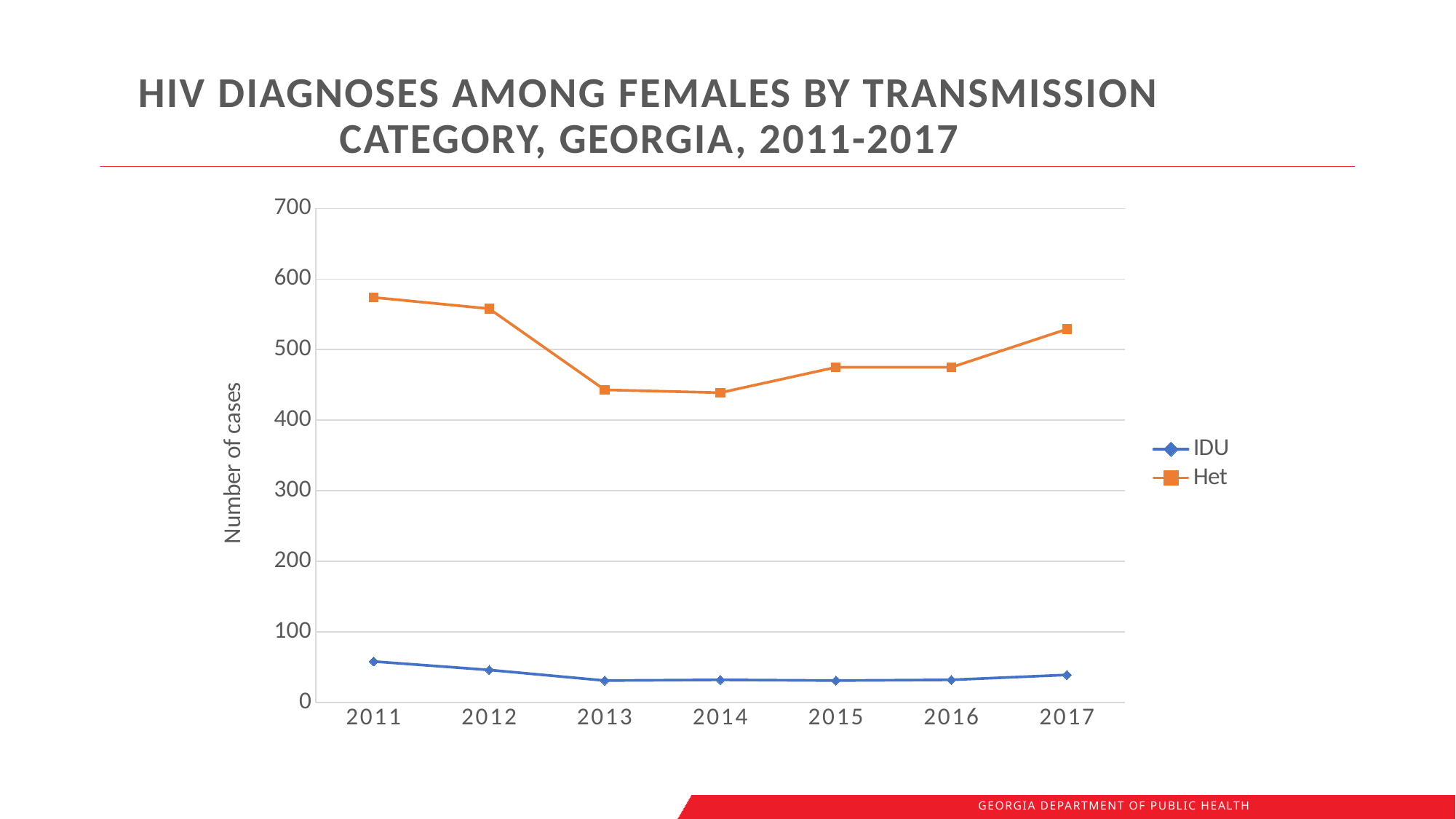
Which is larger, the IDU value in 2011 or the IDU value in 2013? 2011 Is the value for Het in 2013 greater or less than 500? less How many years are plotted along the x axis? 7 Is the value for IDU in 2011 greater or less than 100? less Does the Het series rise or fall from 2014 to 2017? rise In which year is the IDU series at its highest? 2011 In which year is the Het series at its highest? 2011 Which is larger, the Het value in 2011 or the Het value in 2017? 2011 What is the label on the vertical axis? Number of cases Is the value for Het in 2011 greater or less than 500? greater How many series does the legend list? 2 What kind of chart is shown on the slide? line chart